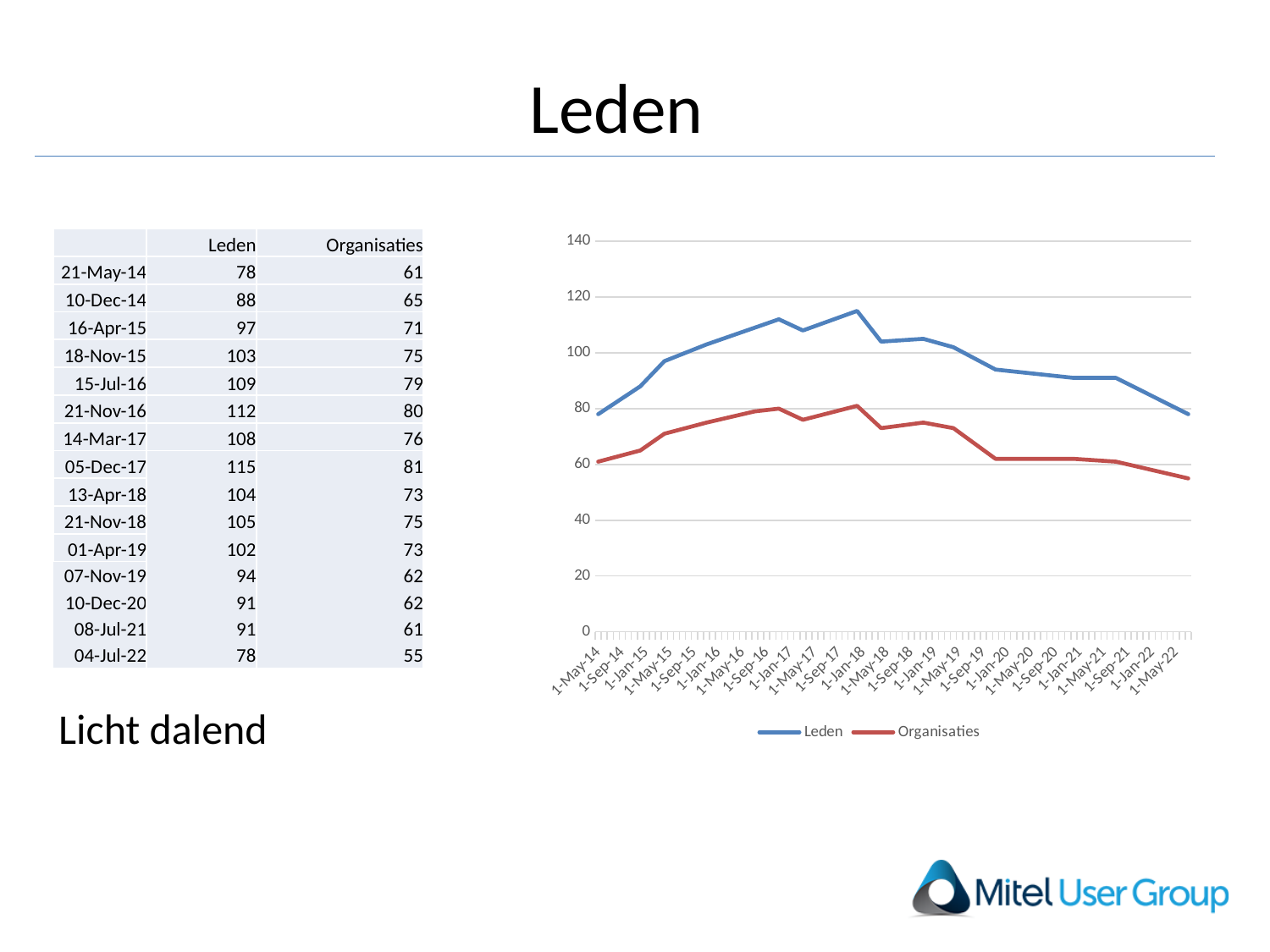
What kind of chart is shown on the slide? line chart What are the two series named in the chart legend? Leden and Organisaties Which series is higher throughout the chart, Leden or Organisaties? Leden According to the table on the slide, what is the Organisaties value on 21-Nov-16? 80 On which date does the Leden series reach its highest value? 05-Dec-17 Is the Leden value at 1-Jan-18 greater or less than 100? greater How many series does the chart's legend list? 2 What is the difference between Leden and Organisaties on 21-May-14? 17 On which date does the Organisaties series reach its lowest value? 04-Jul-22 Which colour is the Leden line drawn in? blue According to the table on the slide, what is the Leden value on 05-Dec-17? 115 Does the Leden line rise or fall from 2018 to 2022? fall